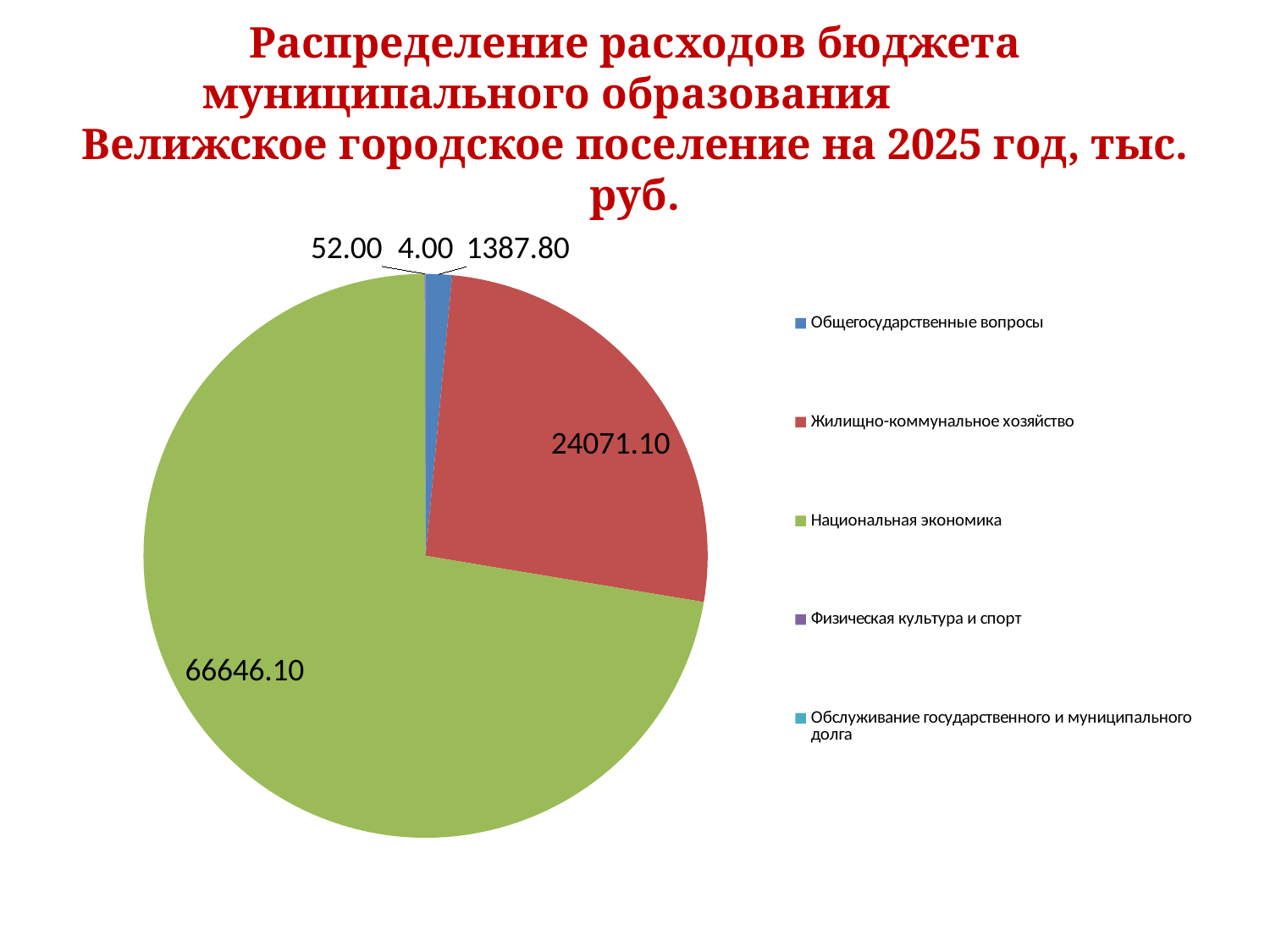
What is the value for Жилищно-коммунальное хозяйство? 24071.10 What is the difference between the values for Национальная экономика and Жилищно-коммунальное хозяйство? 42575.00 What is the total of all values shown on the pie chart? 92161.00 What colour is the slice for Национальная экономика? green Which category has the largest slice of the pie? Национальная экономика Which is larger: Жилищно-коммунальное хозяйство or Общегосударственные вопросы? Жилищно-коммунальное хозяйство How many categories does the legend of the pie chart list? 5 What is the value for Общегосударственные вопросы? 1387.80 What is the value for Национальная экономика? 66646.10 What is the smallest data label shown on the pie chart? 4.00 For which year does the chart title say the budget expenditures are distributed? 2025 What type of chart is shown on the slide? pie chart